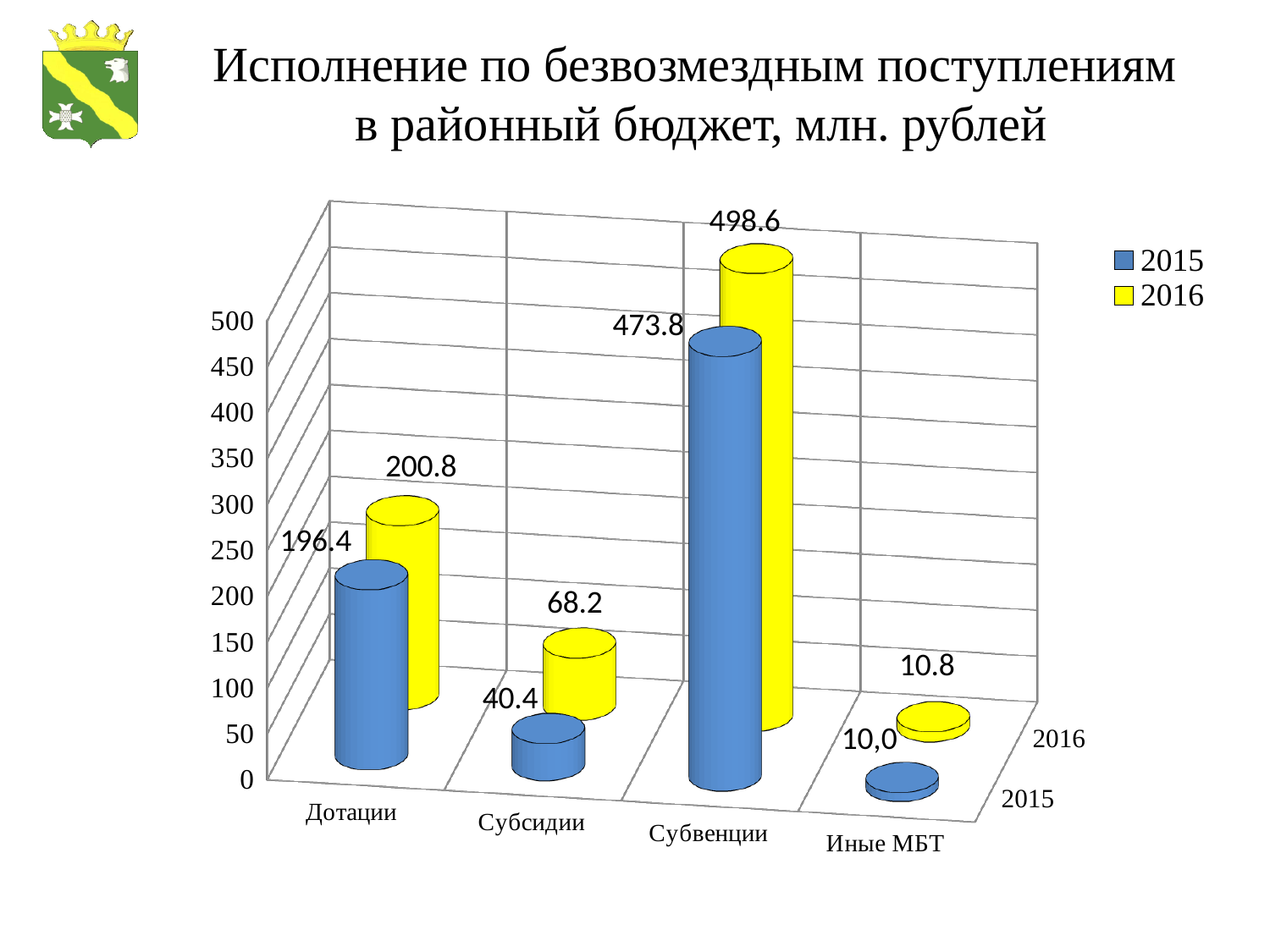
Which category has the lowest value in 2016? Иные МБТ Which category has the highest value in 2015? Субвенции What is the value for Дотации in 2015? 196.4 What is the difference between the 2016 and 2015 values for Субвенции? 24.8 What is the value for Иные МБТ in 2015? 10,0 How many categories are shown on the x axis? 4 How many series does the legend list? 2 Which is larger for Дотации: the 2015 value or the 2016 value? 2016 What is the value for Субсидии in 2016? 68.2 What is the difference between the 2016 and 2015 values for Субсидии? 27.8 What kind of chart is shown on the slide? bar chart What is the value for Субвенции in 2016? 498.6